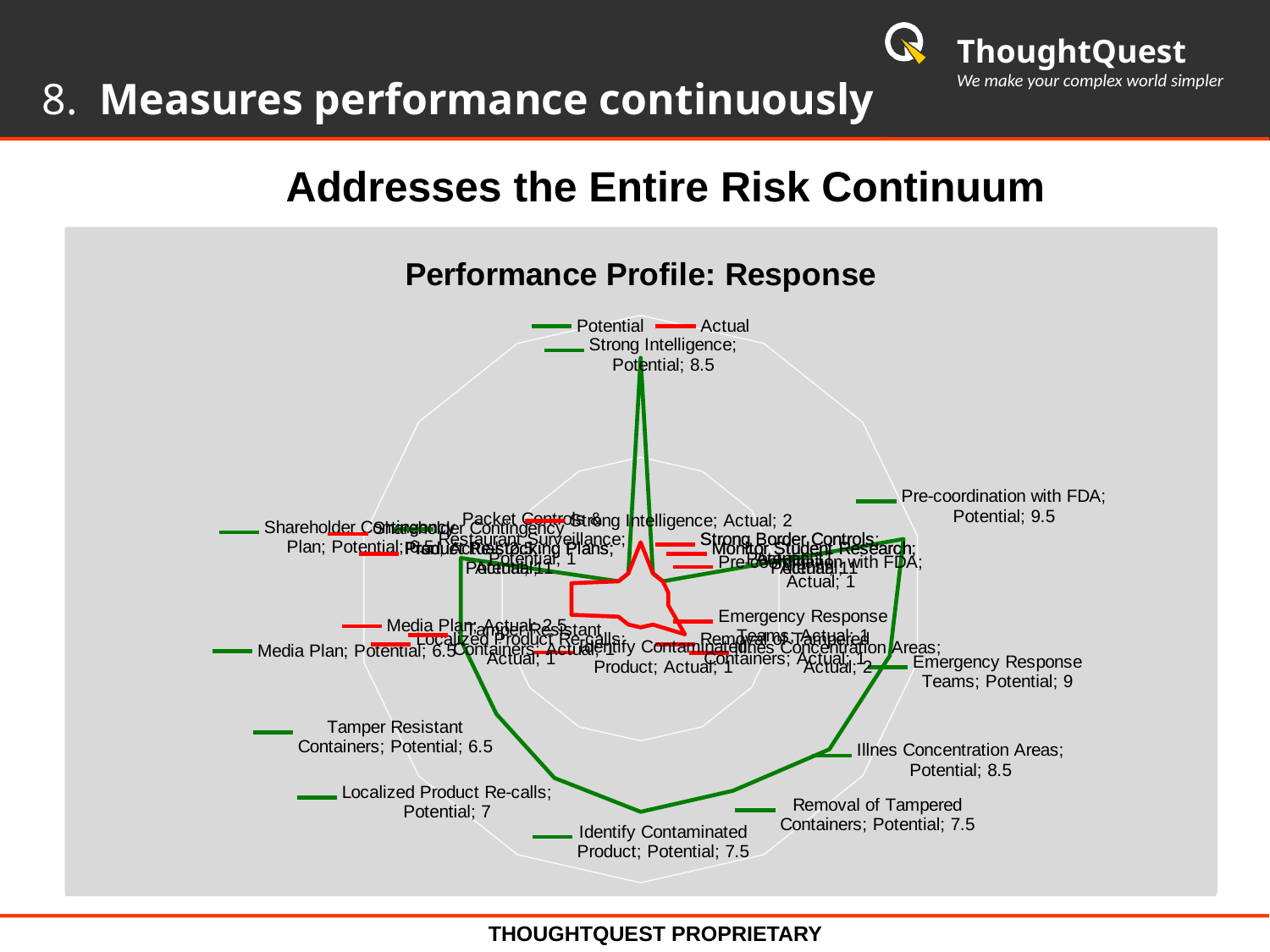
Which is larger, the Potential value for Emergency Response Teams or the Potential value for Tamper Resistant Containers? Emergency Response Teams What is the title of the chart? Performance Profile: Response What is the Potential value for Pre-coordination with FDA? 9.5 Which category has the highest Potential value? Pre-coordination with FDA How many series does the chart legend list? 2 What is the Potential value for Strong Intelligence? 8.5 What kind of chart is shown on the slide? Radar chart What is the difference between the Potential and Actual values for Pre-coordination with FDA? 8.5 What is the Actual value for Media Plan? 2.5 What is the Potential value for Localized Product Re-calls? 7 What is the Actual value for Strong Intelligence? 2 What is the Potential value for Emergency Response Teams? 9